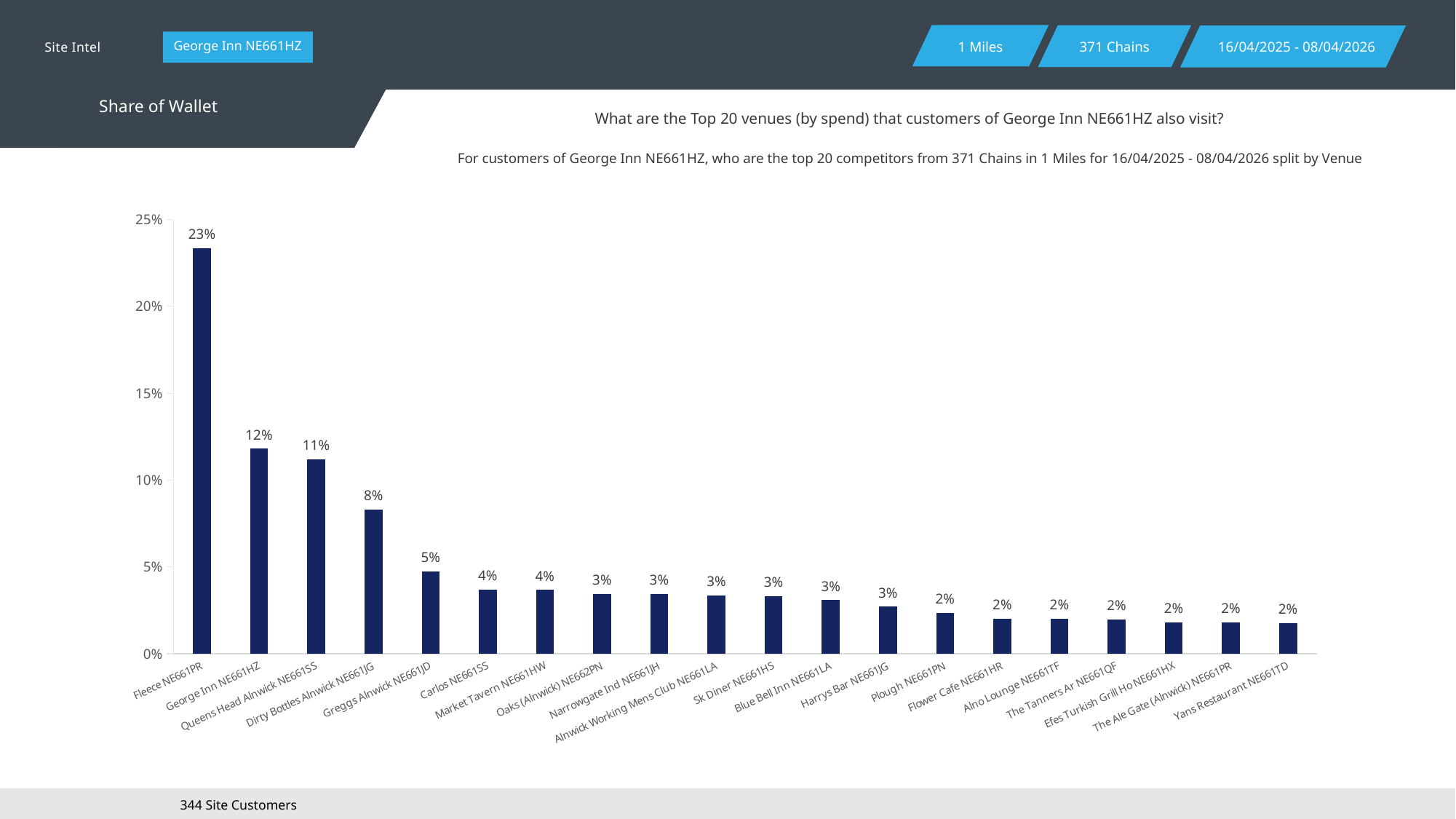
What is the value for Plough NE661PN? 2% How many venues are shown on the x axis? 20 Which is larger, the value for Dirty Bottles Alnwick NE661JG or Greggs Alnwick NE661JD? Dirty Bottles Alnwick NE661JG Do the values rise or fall from left to right along the x axis? fall What is the value for Fleece NE661PR? 23% What is the difference between the values for Fleece NE661PR and George Inn NE661HZ? 11% What is the difference between the values for Queens Head Alnwick NE661SS and Dirty Bottles Alnwick NE661JG? 3% What is the value for Greggs Alnwick NE661JD? 5% Is the value for Fleece NE661PR greater or less than 20%? greater Which venue has the highest value? Fleece NE661PR What is the value for Queens Head Alnwick NE661SS? 11% What kind of chart is shown on the slide? bar chart